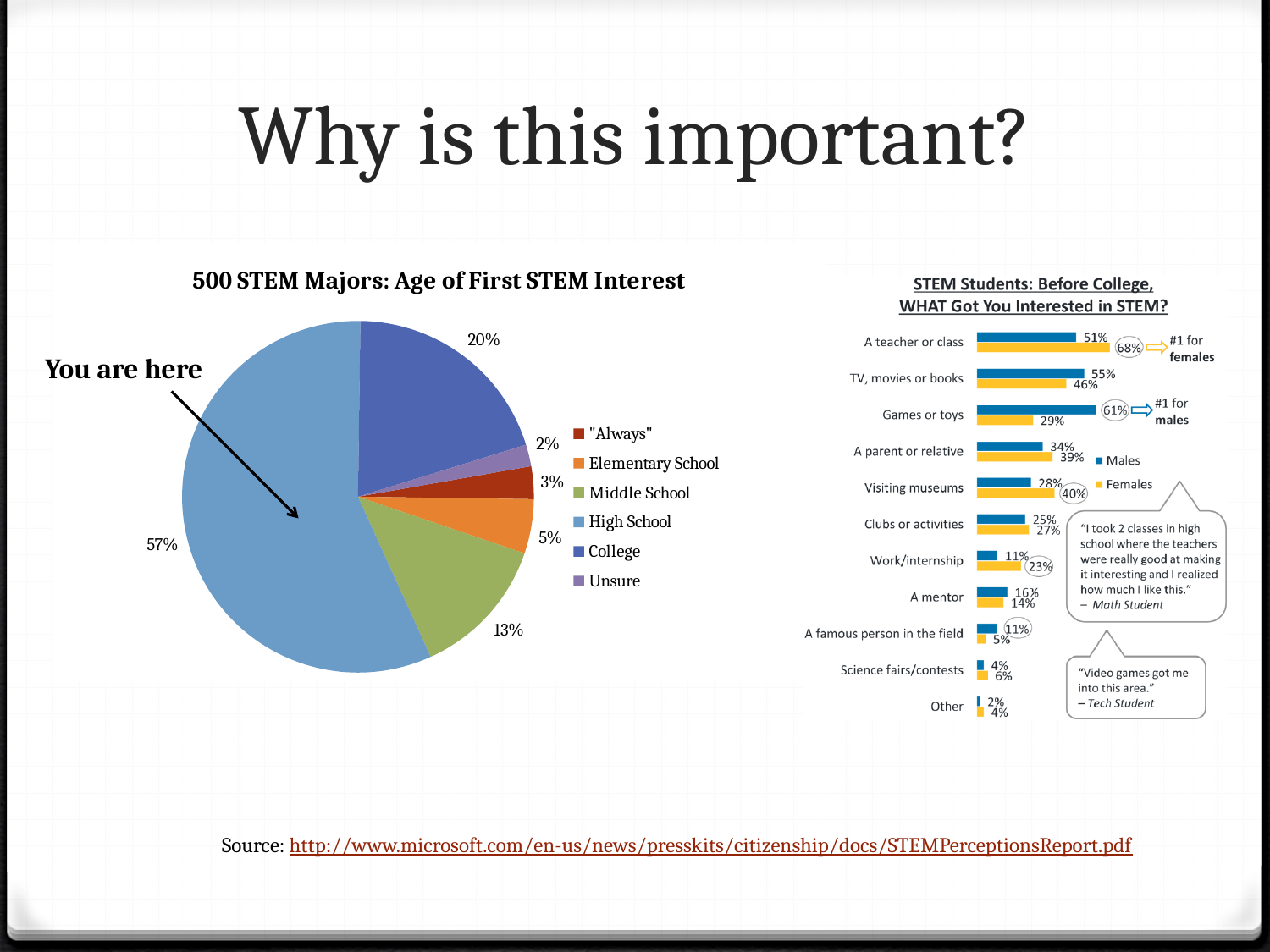
What type of chart is the one on the right of the slide, titled 'STEM Students: Before College, WHAT Got You Interested in STEM?'? Bar chart In the pie chart '500 STEM Majors: Age of First STEM Interest', how many categories does the legend list? 6 In the chart 'STEM Students: Before College, WHAT Got You Interested in STEM?', what is the difference between the Males and Females values for 'Work/internship'? 12% In the chart 'STEM Students: Before College, WHAT Got You Interested in STEM?', how many series does the legend list? 2 In the pie chart '500 STEM Majors: Age of First STEM Interest', which category has the smallest slice? Unsure In the chart 'STEM Students: Before College, WHAT Got You Interested in STEM?', what is the Males value for 'Games or toys'? 61% In the chart 'STEM Students: Before College, WHAT Got You Interested in STEM?', which is larger for 'Visiting museums', the Males value or the Females value? Females In the chart 'STEM Students: Before College, WHAT Got You Interested in STEM?', what is the Females value for 'A teacher or class'? 68% In the pie chart '500 STEM Majors: Age of First STEM Interest', what percentage is shown for College? 20% What type of chart is the one on the left of the slide, titled '500 STEM Majors: Age of First STEM Interest'? Pie chart In the pie chart '500 STEM Majors: Age of First STEM Interest', what is the difference between the Middle School and Elementary School percentages? 8% In the pie chart '500 STEM Majors: Age of First STEM Interest', what share of the pie is High School? 57%